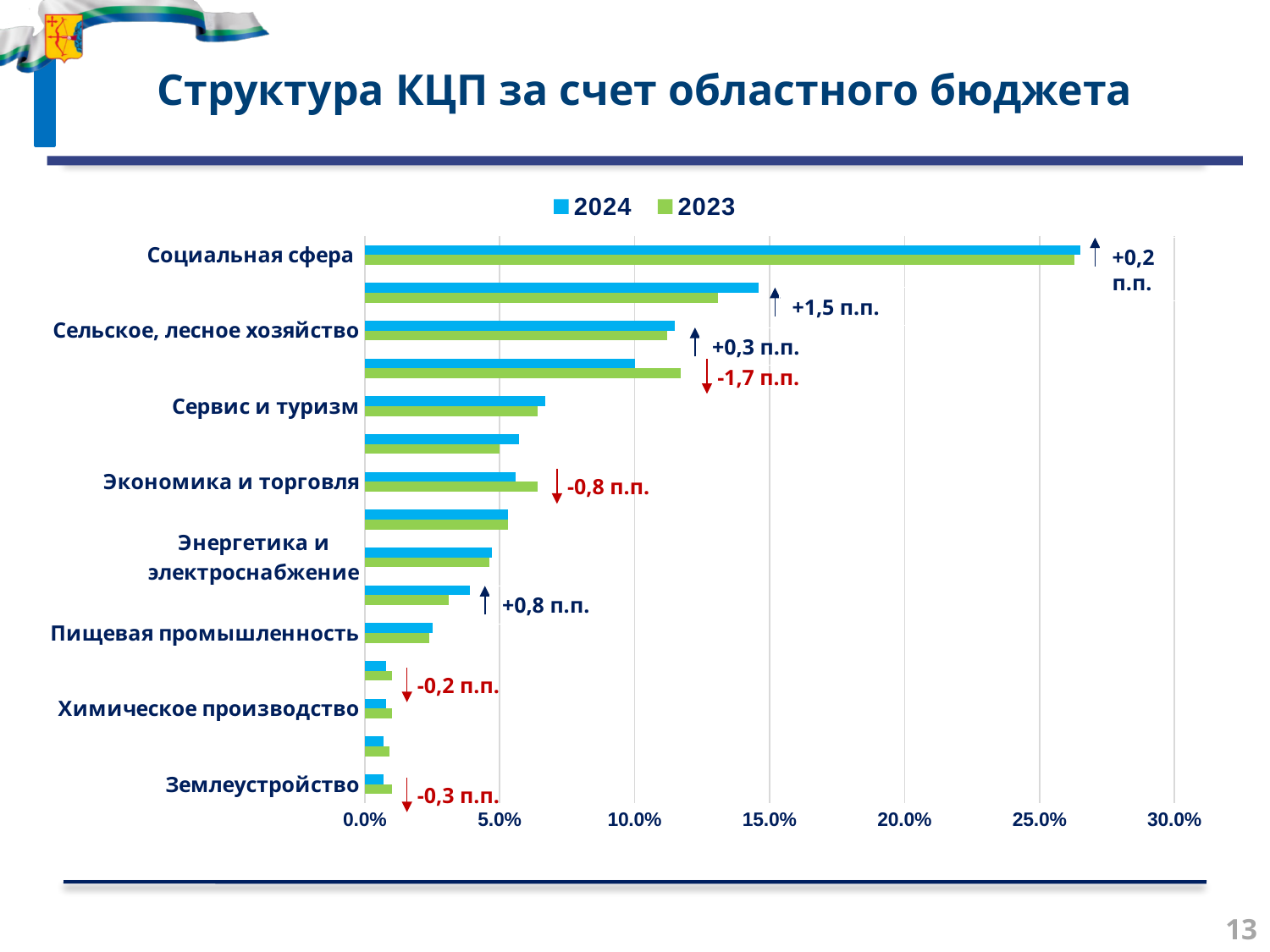
Which category has the highest value for 2024? Социальная сфера What change in percentage points is annotated next to Экономика и торговля? -0,8 п.п. How many series does the legend list? 2 Is the 2024 value for Социальная сфера greater or less than 25.0%? greater Is the 2024 value for Сервис и туризм greater or less than 10.0%? less For Экономика и торговля, which year has the larger value, 2024 or 2023? 2023 Is the 2024 value for Сельское, лесное хозяйство greater or less than 10.0%? greater What kind of chart is shown on the slide? bar chart What change in percentage points is annotated next to Землеустройство? -0,3 п.п. What change in percentage points is annotated next to Социальная сфера? +0,2 п.п. What are the two series named in the legend? 2024 and 2023